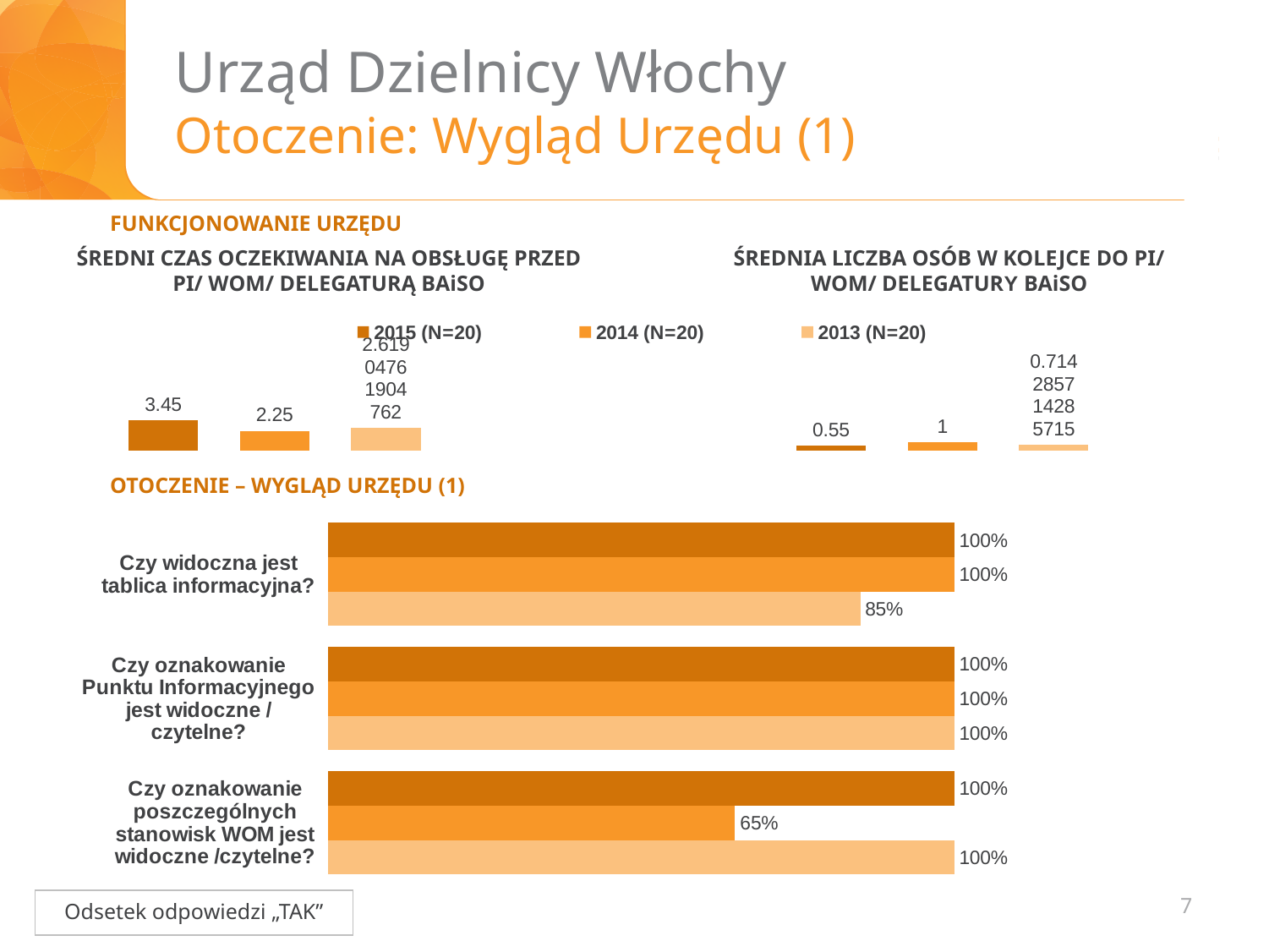
In the chart 'ŚREDNIA LICZBA OSÓB W KOLEJCE DO PI/ WOM/ DELEGATURY BAiSO', what is the value for 2014 (N=20)? 1 In the chart 'ŚREDNIA LICZBA OSÓB W KOLEJCE DO PI/ WOM/ DELEGATURY BAiSO', what is the value for 2015 (N=20)? 0.55 In the chart 'ŚREDNI CZAS OCZEKIWANIA NA OBSŁUGĘ PRZED PI/ WOM/ DELEGATURĄ BAiSO', what is the value for 2014 (N=20)? 2.25 In the chart 'ŚREDNI CZAS OCZEKIWANIA NA OBSŁUGĘ PRZED PI/ WOM/ DELEGATURĄ BAiSO', what is the value for 2015 (N=20)? 3.45 In the bottom chart 'OTOCZENIE – WYGLĄD URZĘDU (1)', what is the value of the middle bar for 'Czy oznakowanie poszczególnych stanowisk WOM jest widoczne /czytelne?'? 65% How many series does the legend above the two top charts list? 3 In the chart 'ŚREDNIA LICZBA OSÓB W KOLEJCE DO PI/ WOM/ DELEGATURY BAiSO', which year has the lowest value? 2015 (N=20) In the bottom chart 'OTOCZENIE – WYGLĄD URZĘDU (1)', what is the difference between the top bar and the middle bar for 'Czy oznakowanie poszczególnych stanowisk WOM jest widoczne /czytelne?'? 35% What kind of chart is 'OTOCZENIE – WYGLĄD URZĘDU (1)'? Bar chart In the bottom chart 'OTOCZENIE – WYGLĄD URZĘDU (1)', what is the value of the lightest (bottom) bar for 'Czy widoczna jest tablica informacyjna?'? 85% In the chart 'ŚREDNI CZAS OCZEKIWANIA NA OBSŁUGĘ PRZED PI/ WOM/ DELEGATURĄ BAiSO', which year has the highest value? 2015 (N=20) How many question categories are shown in the bottom chart 'OTOCZENIE – WYGLĄD URZĘDU (1)'? 3